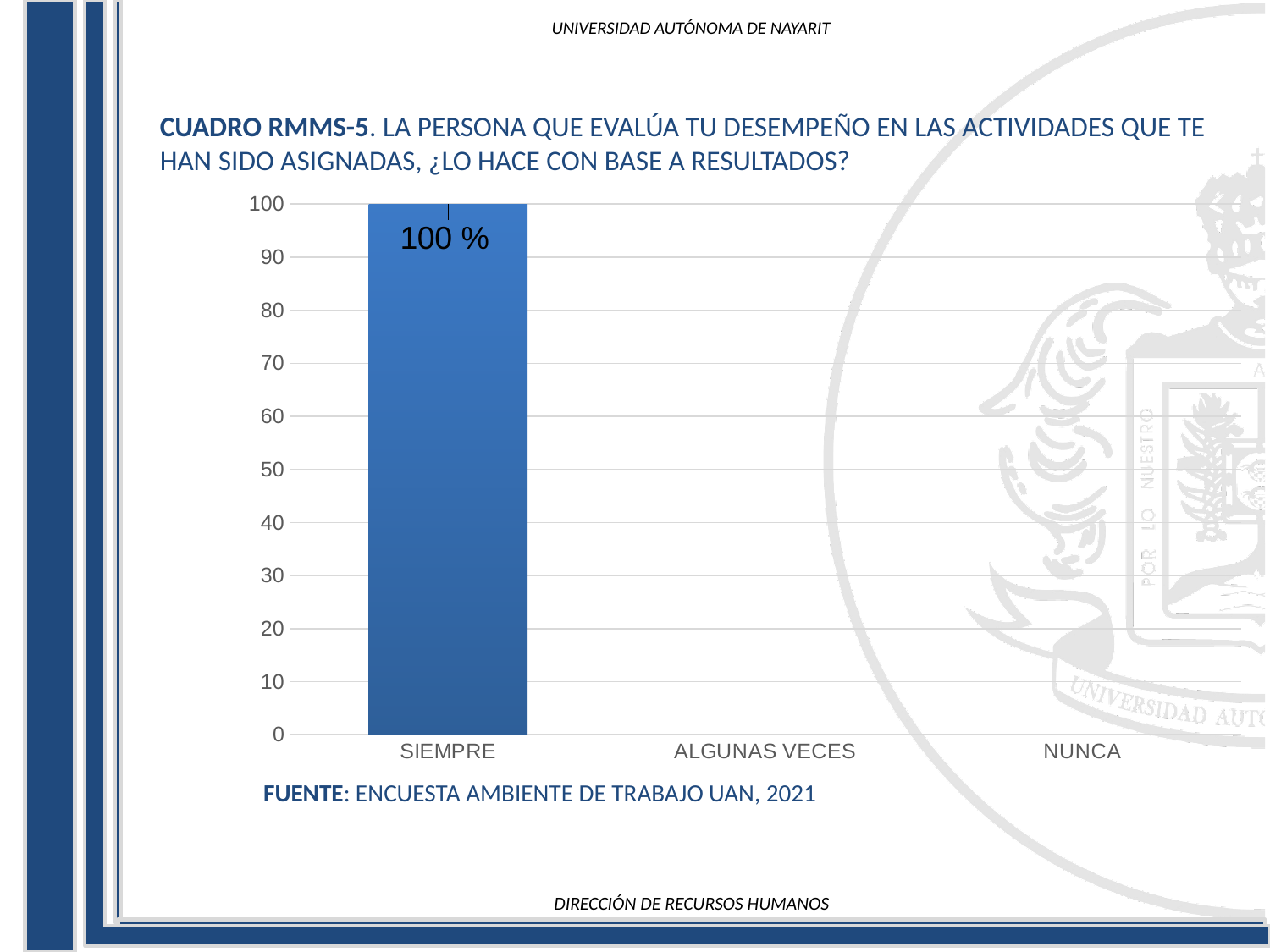
Which is larger, the value for SIEMPRE or the value for ALGUNAS VECES? SIEMPRE What is the highest value shown on the y axis? 100 What source is cited below the chart? ENCUESTA AMBIENTE DE TRABAJO UAN, 2021 What value is shown for SIEMPRE? 100 % How many categories have a visible bar? 1 What kind of chart is shown on the slide? bar chart Is the value for SIEMPRE greater or less than 50? greater Which is larger, the value for SIEMPRE or the value for NUNCA? SIEMPRE Which category has the highest value? SIEMPRE How many categories are shown on the x axis? 3